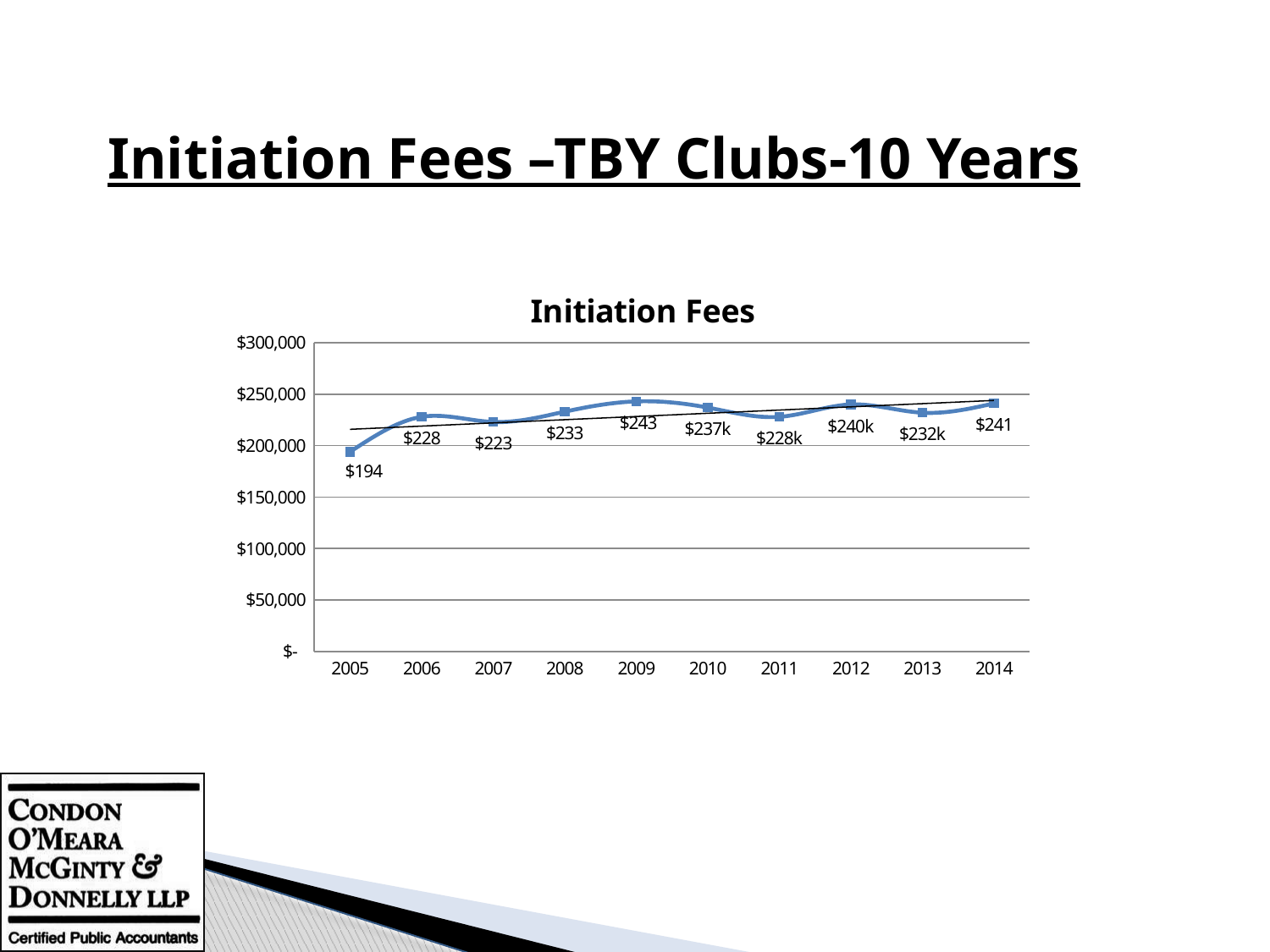
What is the initiation fee value labeled for 2005? $194 Which year has the lowest initiation fee value? 2005 What is the title of the chart? Initiation Fees Which year has the highest initiation fee value? 2009 What kind of chart is shown on the slide? line chart What is the initiation fee value labeled for 2009? $243 Is the initiation fee value for 2005 greater or less than $200,000? less How many years are plotted on the x axis of the chart? 10 Is the initiation fee value for 2009 greater or less than $250,000? less Which year has a larger initiation fee value, 2006 or 2007? 2006 What is the initiation fee value labeled for 2014? $241 What is the initiation fee value labeled for 2012? $240k